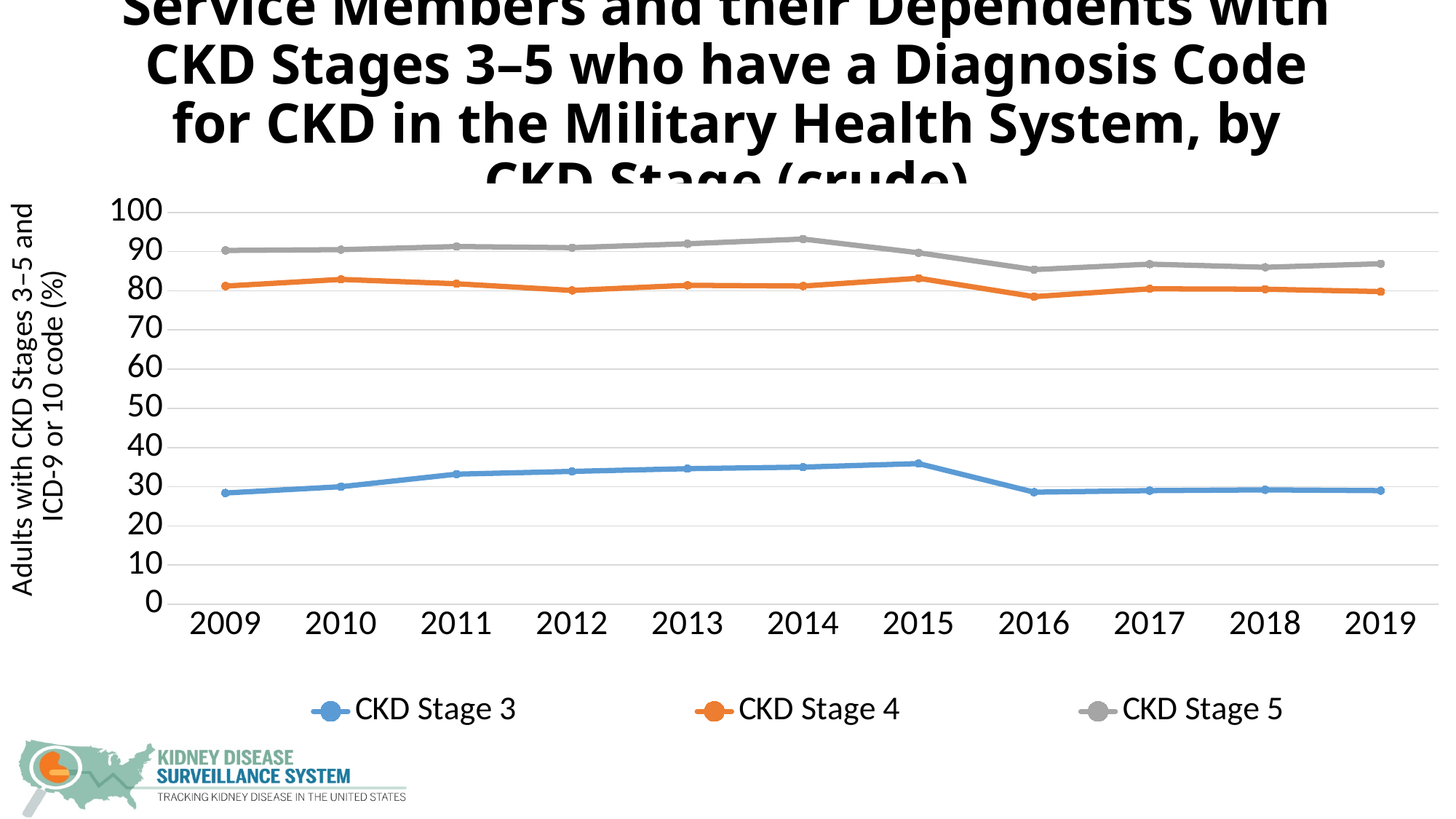
What colour is the CKD Stage 4 line in the legend? orange How many series does the legend list? 3 Is the value for CKD Stage 5 in 2016 greater or less than 90? less Is the value for CKD Stage 5 in 2014 greater or less than 90? greater In which year is the CKD Stage 5 value highest? 2014 Is the value for CKD Stage 3 in 2015 greater or less than 30? greater How many years are plotted along the x axis? 11 In which year is the CKD Stage 3 value highest? 2015 What kind of chart is shown on the slide? line chart Does the CKD Stage 3 line rise or fall from 2015 to 2016? fall Which series has the highest value in 2019? CKD Stage 5